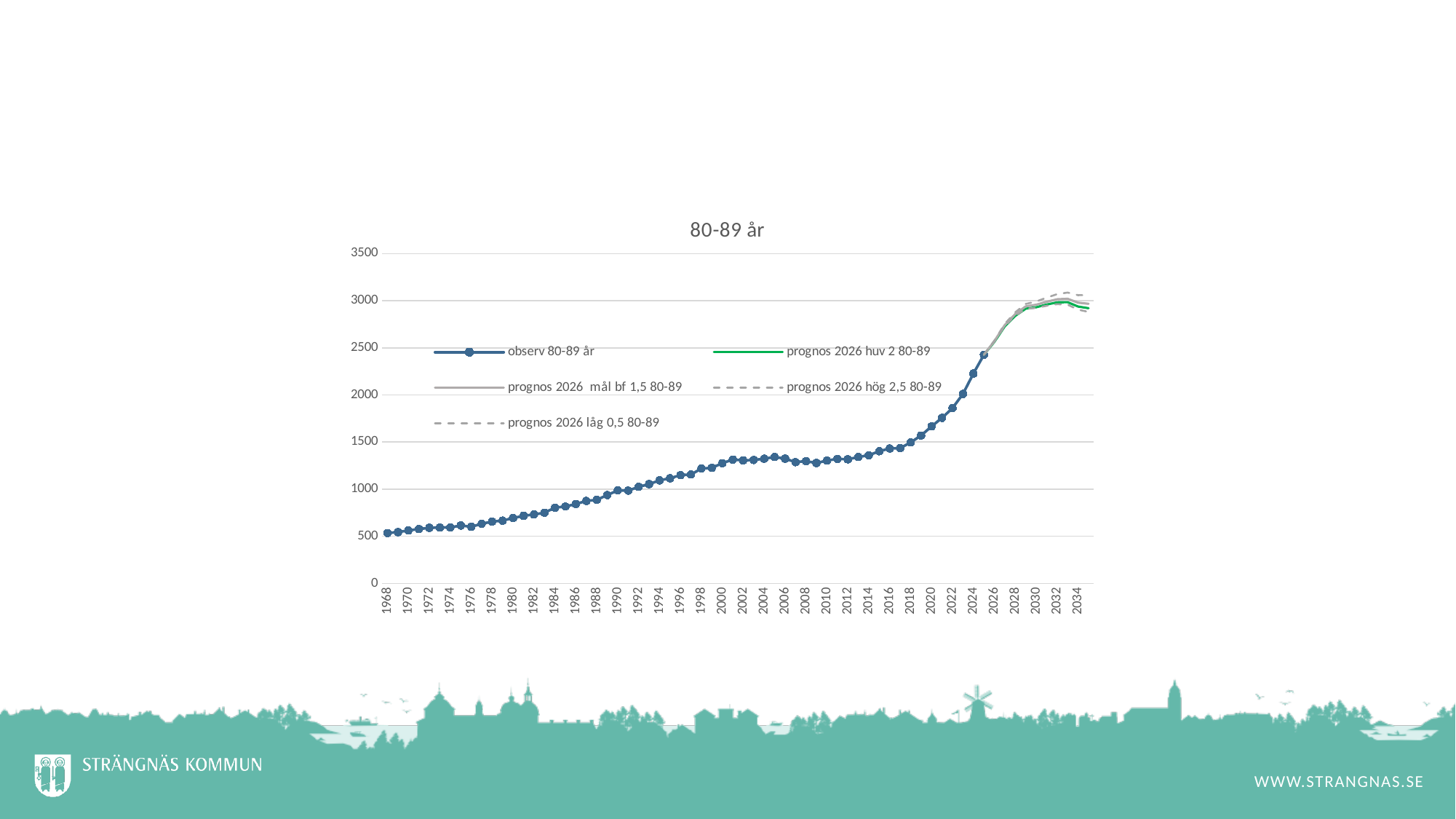
Does the observ 80-89 år series generally rise or fall from 1968 to 2024? rise Is the value of the prognos 2026 hög 2,5 80-89 series in 2032 greater or less than 2500? greater Which series in the legend is drawn with markers (dots) on the line? observ 80-89 år Is the value of the observ 80-89 år series in 2000 greater or less than 1000? greater How many series does the legend list? 5 Is the value of the observ 80-89 år series in 1968 greater or less than 1000? less What kind of chart is shown on the slide? line chart In which year does the observ 80-89 år series reach its highest value? 2025 What is the title of the chart? 80-89 år Which is larger for the observ 80-89 år series: the value in 1990 or the value in 2020? 2020